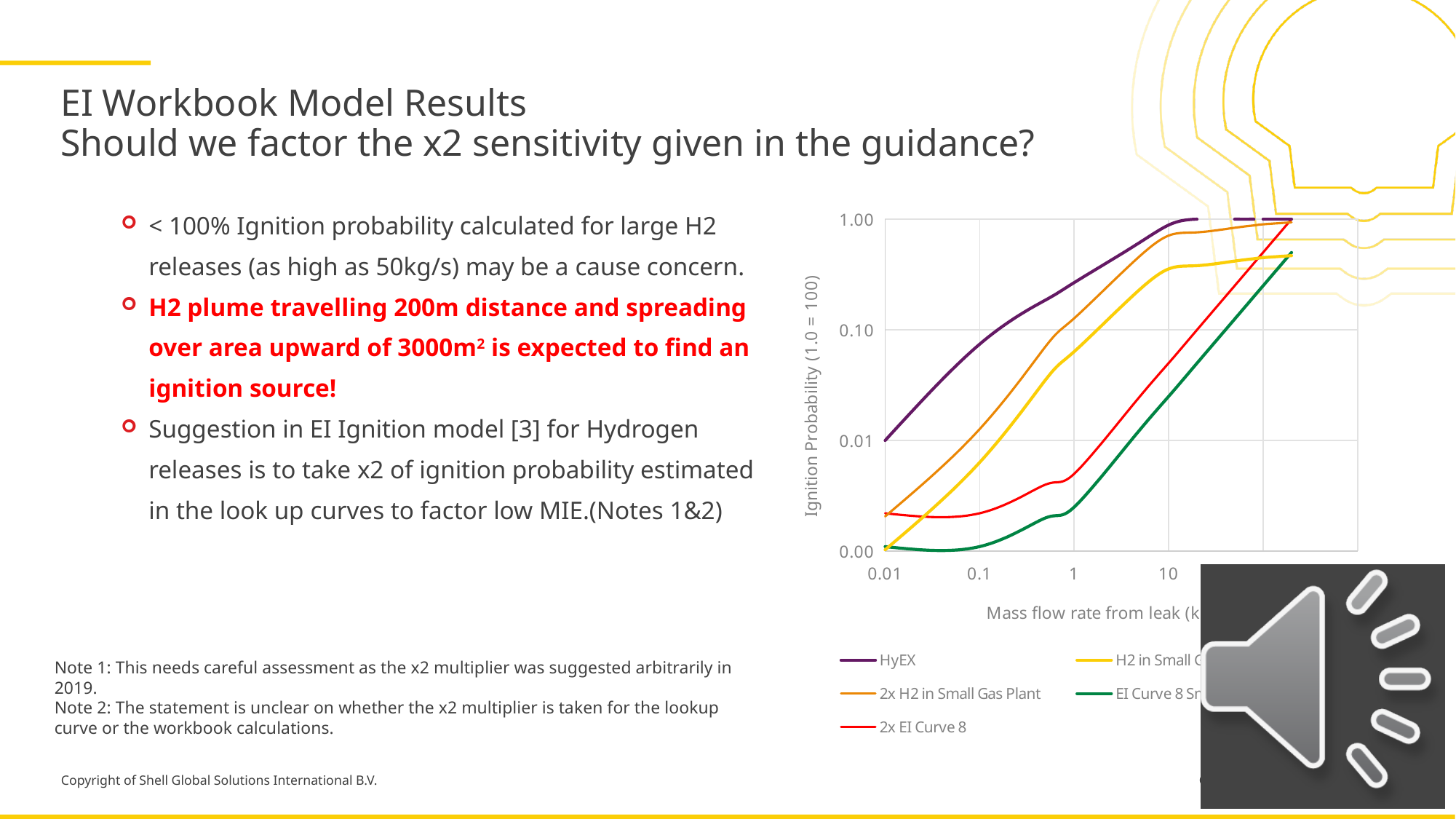
What is the title of the chart's vertical axis? Ignition Probability (1.0 = 100) How many series does the chart's legend list? 5 What kind of chart is shown on the slide? line chart At a mass flow rate of 1, which is higher: HyEX or 2x EI Curve 8? HyEX At a mass flow rate of 10, is the 2x H2 in Small Gas Plant value greater or less than 0.10? greater Does the HyEX line rise or fall as mass flow rate increases along the x axis? rises At a mass flow rate of 1, is the 2x EI Curve 8 value greater or less than 0.01? less At a mass flow rate of 0.1, is the HyEX value greater or less than 0.01? greater Which series has the highest ignition probability at a mass flow rate of 0.1? HyEX At a mass flow rate of 0.1, which is higher: 2x H2 in Small Gas Plant or 2x EI Curve 8? 2x H2 in Small Gas Plant What colour is the HyEX line in the chart? purple